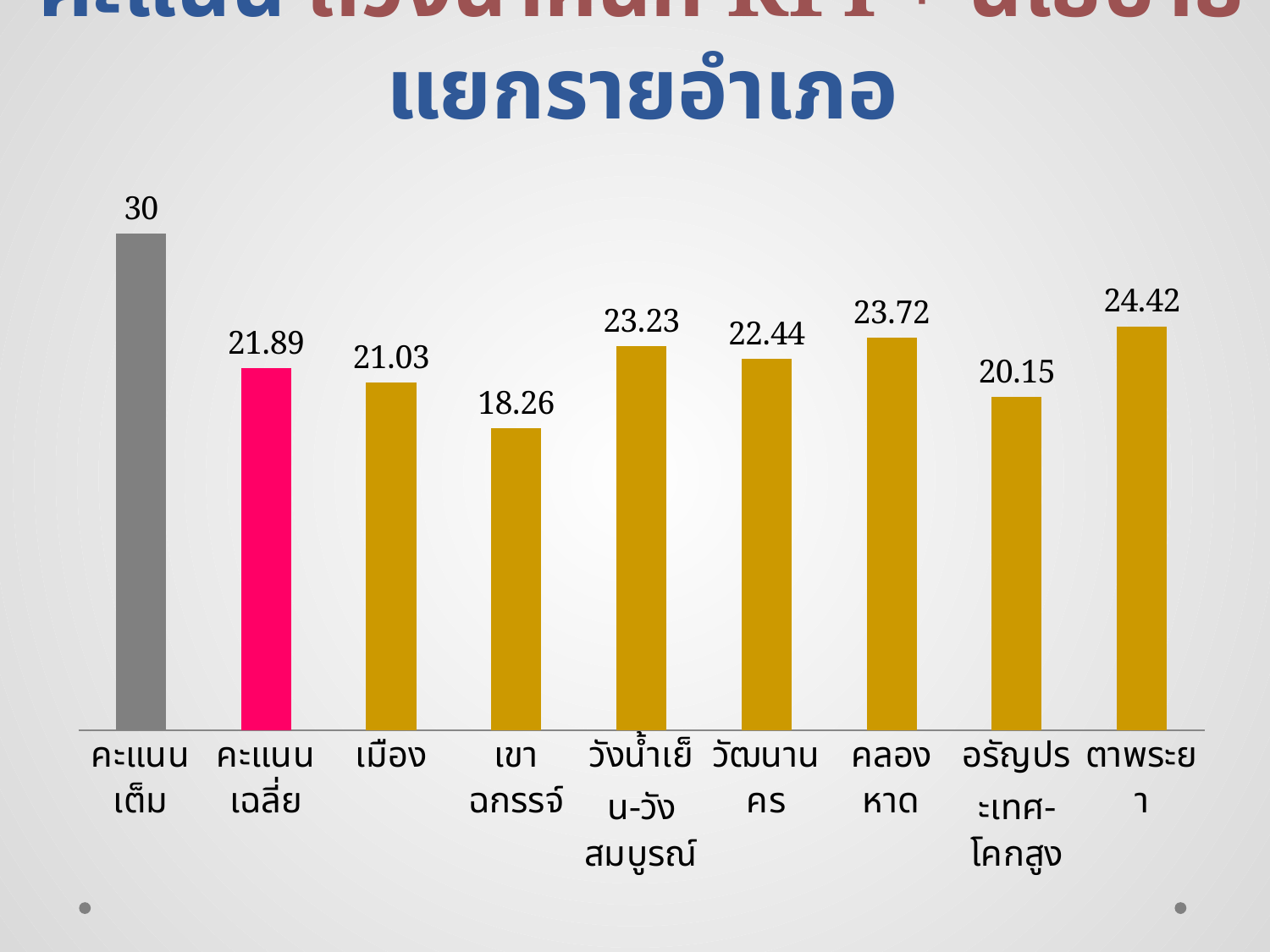
Which category has the highest bar in the chart? คะแนนเต็ม How many bars are shown in the chart? 9 What value is shown for คลองหาด? 23.72 What is the difference between the values for ตาพระยา and เขาฉกรรจ์? 6.16 What value is shown for คะแนนเฉลี่ย? 21.89 What value is shown for ตาพระยา? 24.42 What kind of chart is shown on the slide? bar chart What value is shown for เขาฉกรรจ์? 18.26 What value is shown for เมือง? 21.03 Which is larger, the value for วัฒนานคร or the value for อรัญประเทศ-โคกสูง? วัฒนานคร What is the difference between คะแนนเต็ม and คะแนนเฉลี่ย? 8.11 Which category has the lowest value in the chart? เขาฉกรรจ์